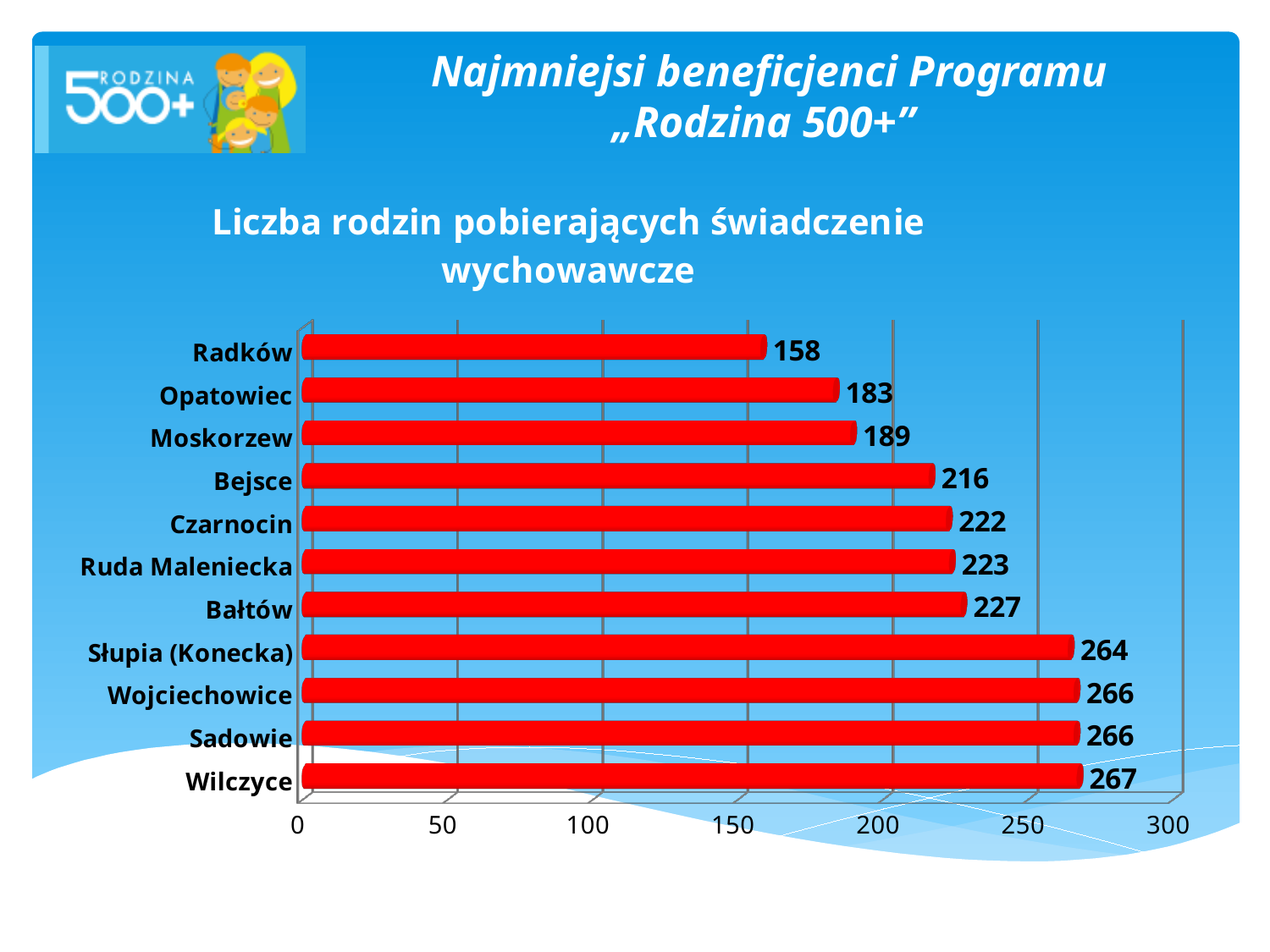
Which is larger, the value for Moskorzew or the value for Czarnocin? Czarnocin Which category has the lowest value? Radków What is the value for Bejsce? 216 How many categories are shown in the chart? 11 What colour are the bars in the chart? red What is the difference between the values for Bałtów and Radków? 69 What is the value for Radków? 158 Is the value for Opatowiec greater or less than 200? less What is the title of the chart? Liczba rodzin pobierających świadczenie wychowawcze What is the value for Słupia (Konecka)? 264 What kind of chart is shown on the slide? bar chart Which category has the highest value? Wilczyce